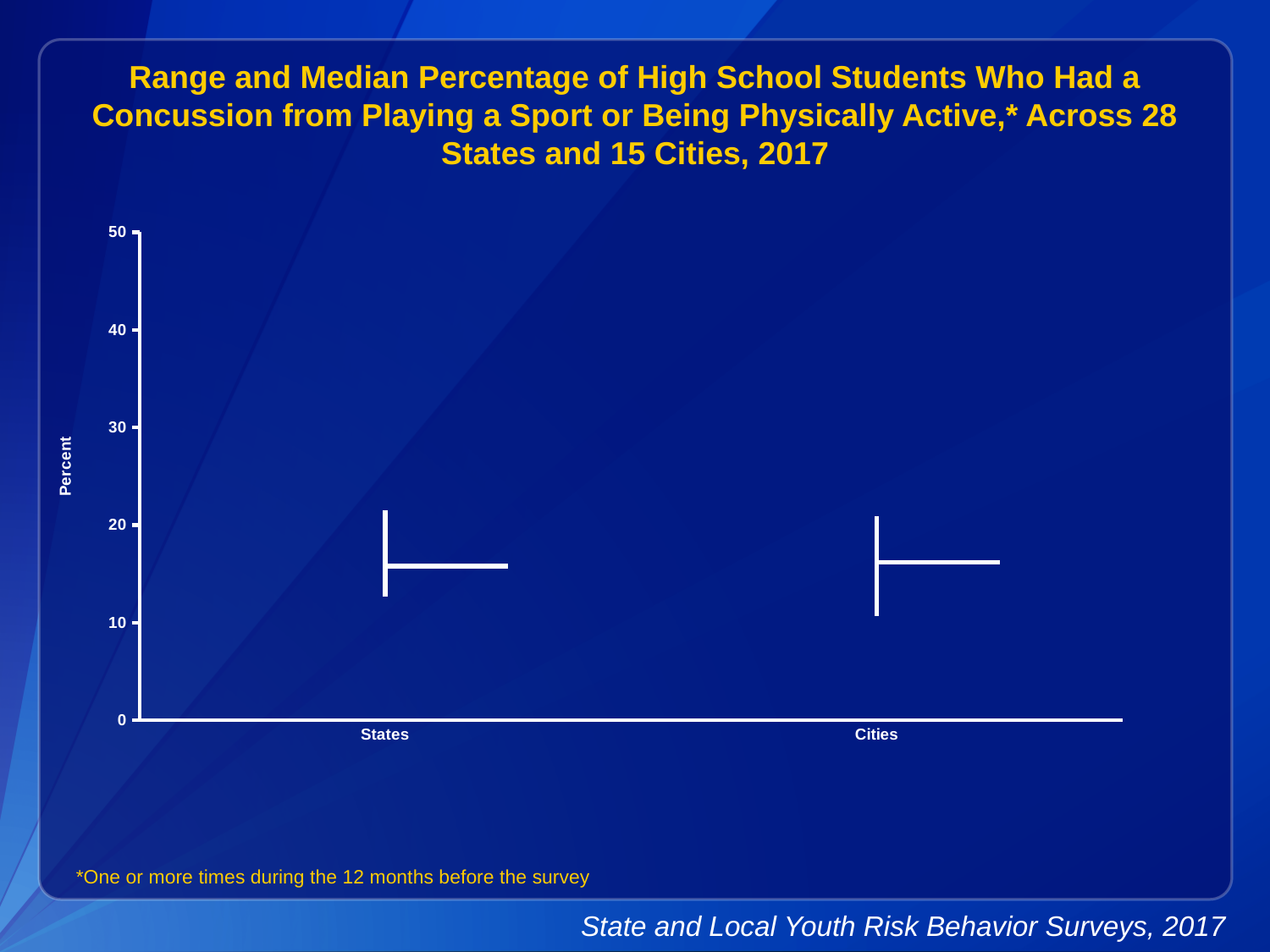
Is the median value for States greater or less than 10? greater Is the median value for States greater or less than 20? less Is the lowest value of the range for Cities greater or less than 20? less What is the highest value shown on the y axis? 50 How many categories are shown on the x axis of the chart? 2 What is the label of the y axis? Percent What are the two categories shown on the x axis? States and Cities